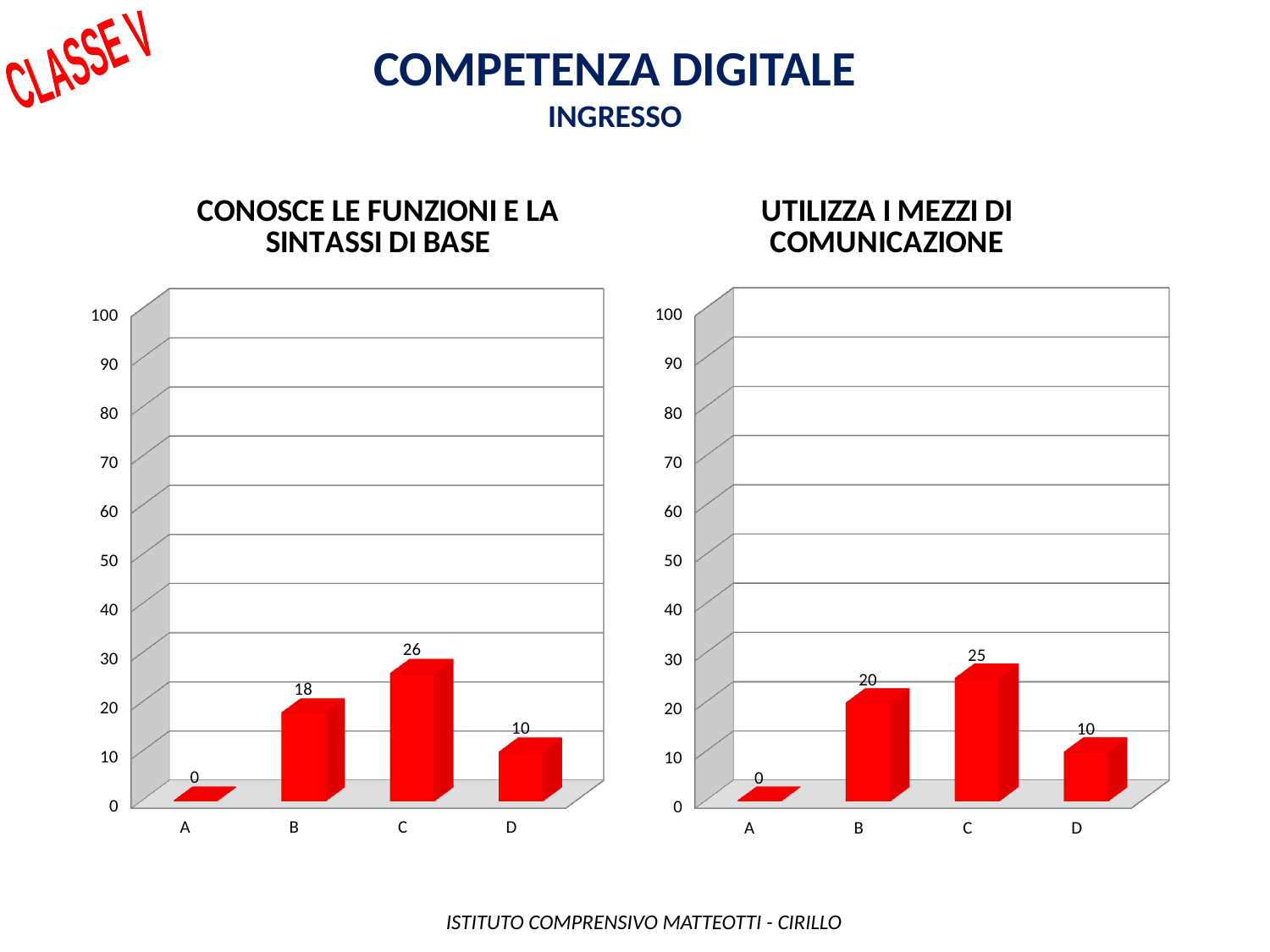
In the right chart ("UTILIZZA I MEZZI DI COMUNICAZIONE"), is the value for C greater or less than 20? greater In the chart titled "UTILIZZA I MEZZI DI COMUNICAZIONE", what is the value for category D? 10 How many categories are shown on the x axis of the chart titled "CONOSCE LE FUNZIONI E LA SINTASSI DI BASE"? 4 In the chart titled "UTILIZZA I MEZZI DI COMUNICAZIONE", what is the value for category B? 20 In the right chart ("UTILIZZA I MEZZI DI COMUNICAZIONE"), which category has the lowest value? A In the chart titled "CONOSCE LE FUNZIONI E LA SINTASSI DI BASE", what is the value for category C? 26 In the left chart ("CONOSCE LE FUNZIONI E LA SINTASSI DI BASE"), which category has the highest value? C In the left chart ("CONOSCE LE FUNZIONI E LA SINTASSI DI BASE"), which is larger, the value for B or the value for D? B What kind of chart is the one titled "UTILIZZA I MEZZI DI COMUNICAZIONE"? Bar chart In the chart titled "UTILIZZA I MEZZI DI COMUNICAZIONE", what is the difference between the values for C and D? 15 In the chart titled "CONOSCE LE FUNZIONI E LA SINTASSI DI BASE", what is the difference between the values for C and B? 8 What is the maximum value shown on the vertical axis of the left chart ("CONOSCE LE FUNZIONI E LA SINTASSI DI BASE")? 100